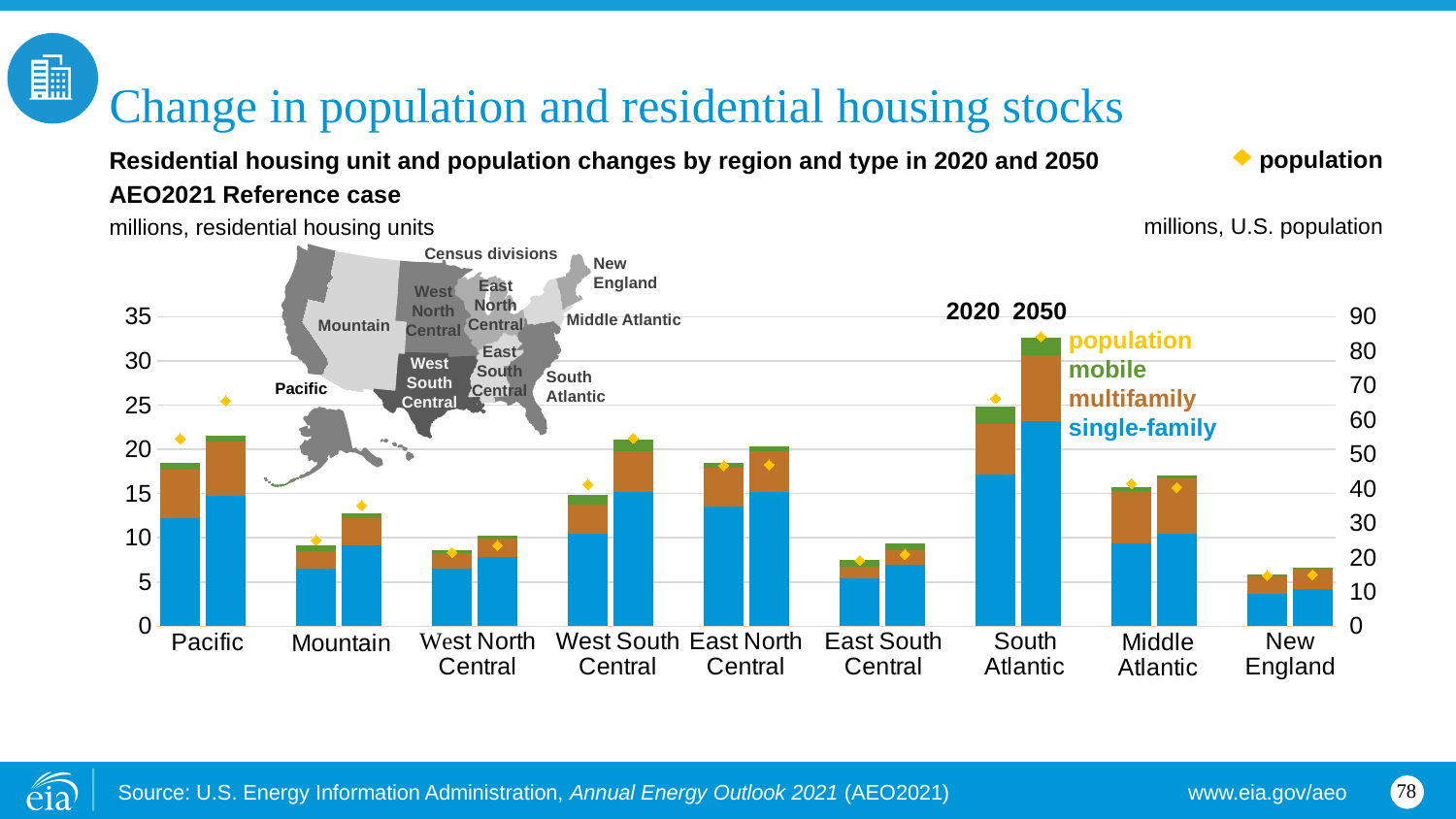
Is the total residential housing units for Pacific in 2020 greater or less than 15 million? greater How many series does the chart legend list? 4 What kind of chart is shown on the slide? stacked bar chart How many census divisions (regions) are shown along the x axis of the chart? 9 Which region has the tallest stacked bar for residential housing units in 2050? South Atlantic Which has more total residential housing units in 2020, Pacific or Mountain? Pacific Which series in the chart is plotted as diamond markers rather than bars? population Which has more total residential housing units in 2020, South Atlantic or Middle Atlantic? South Atlantic Is the total residential housing units for New England in 2020 greater or less than 10 million? less Is the total residential housing units for Mountain in 2050 greater or less than 10 million? greater Which region has the shortest stacked bar for residential housing units in 2020? New England